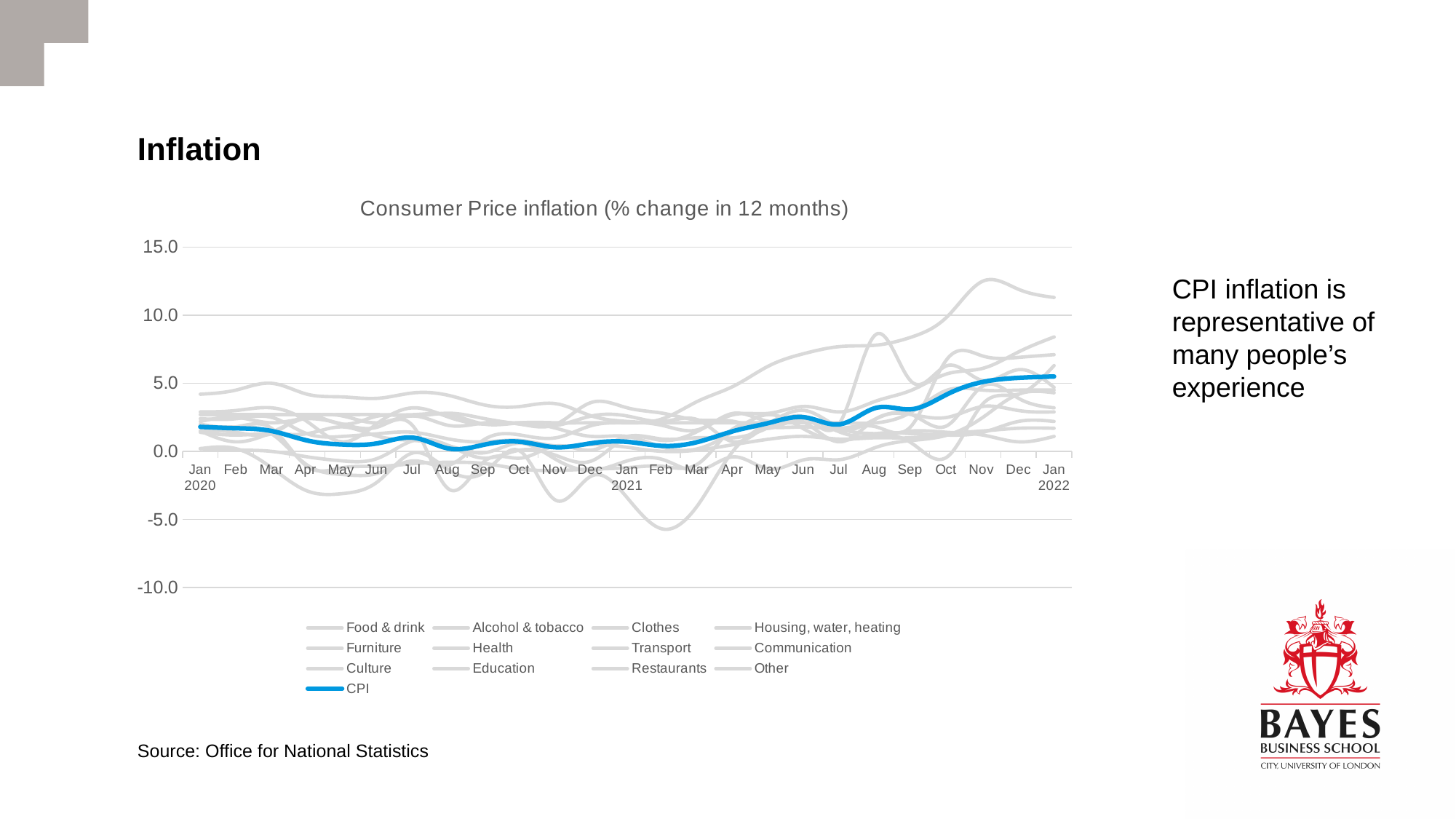
Is the lowest value plotted on the chart (reached by a grey series around Feb 2021) greater or less than -5.0? less What kind of chart is shown on the slide? Line chart Does the CPI line rise or fall overall between Jan 2020 and Jan 2022? Rises Is the highest value plotted on the chart (reached by a grey series around Nov 2021) greater or less than 10.0? greater How many series does the legend list? 13 Is the CPI value for Jan 2022 greater or less than 5.0? greater What is the title of the chart? Consumer Price inflation (% change in 12 months) How many monthly points are plotted along the x axis, from Jan 2020 to Jan 2022? 25 Which is larger for CPI: the value in Jan 2021 or the value in Jan 2022? Jan 2022 Which is larger for CPI: the value in Jan 2020 or the value in Aug 2020? Jan 2020 Which series is drawn in blue rather than grey? CPI